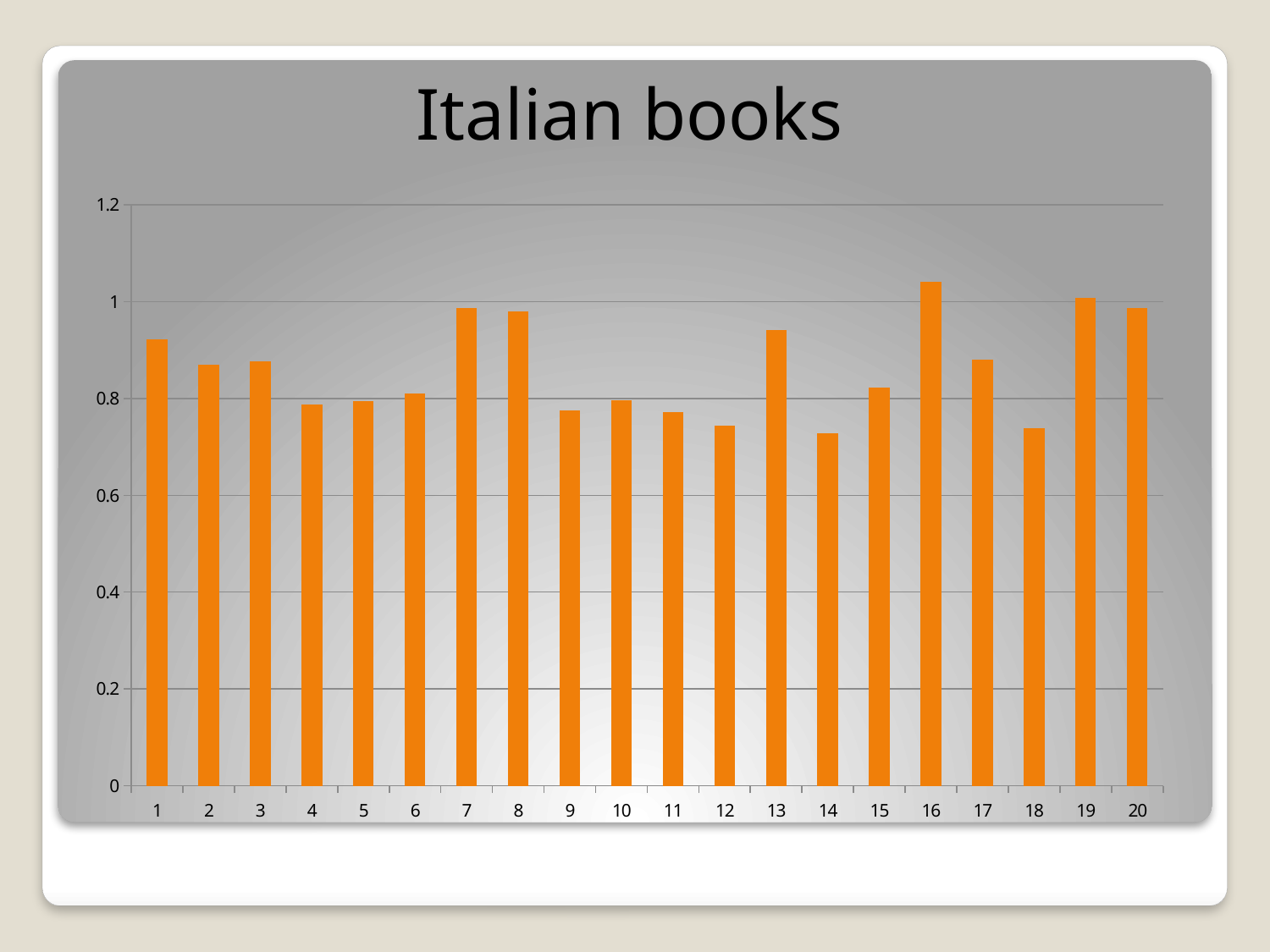
How many categories are plotted on the x axis? 20 What type of chart is shown on the slide? bar chart Which is larger, the value for category 1 or category 4? category 1 Which is larger, the value for category 18 or category 19? category 19 Is the value for category 12 greater or less than 0.8? less Is the value for category 7 greater or less than 1? less Is the value for category 13 greater or less than 0.8? greater Which is larger, the value for category 13 or category 15? category 13 Which category has the highest bar? 16 What is the title of the chart? Italian books